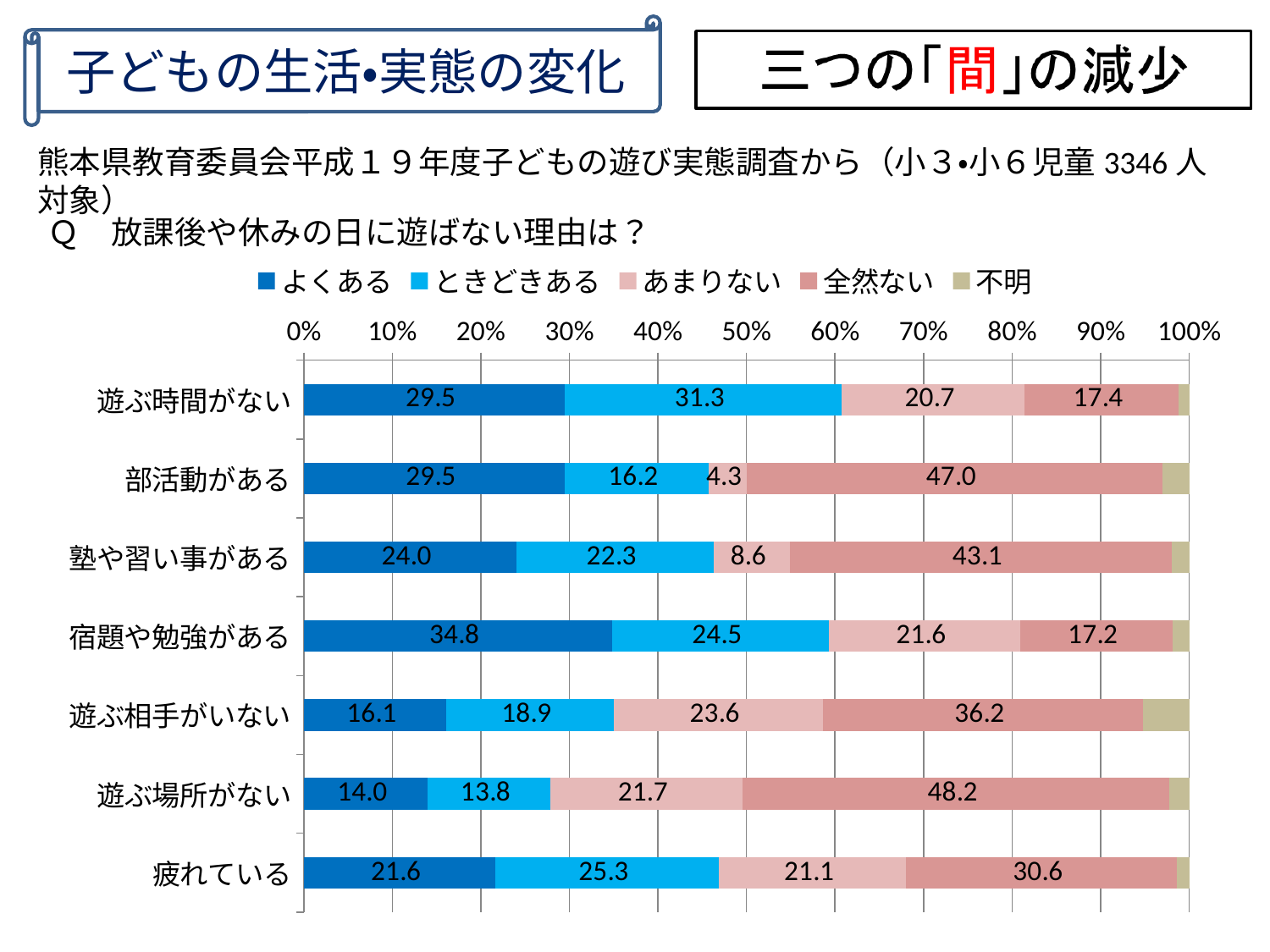
How many categories (reasons) are plotted on the chart? 7 What is the よくある value for 宿題や勉強がある? 34.8 Which category has the highest よくある value? 宿題や勉強がある Which category has the lowest よくある value? 遊ぶ場所がない What is the difference between the ときどきある and よくある values for 遊ぶ時間がない? 1.8 What is the 全然ない value for 部活動がある? 47.0 What is the ときどきある value for 疲れている? 25.3 Which is larger for 塾や習い事がある: the よくある value or the ときどきある value? よくある How many series does the legend list? 5 What is the あまりない value for 遊ぶ相手がいない? 23.6 What type of chart is shown on the slide? stacked bar chart Which category has the highest 全然ない value? 遊ぶ場所がない